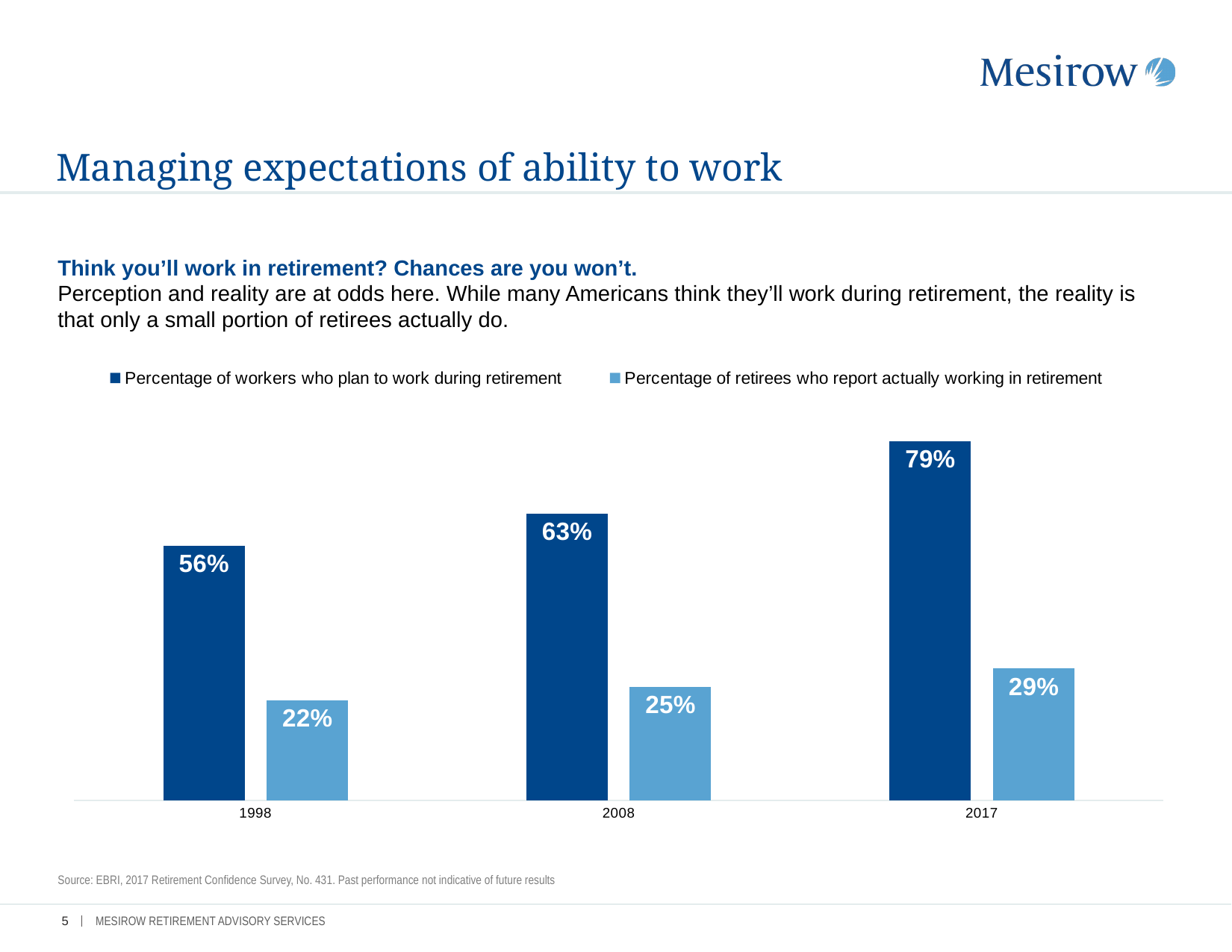
What is the difference between the percentage of workers who plan to work during retirement and the percentage of retirees actually working in retirement in 2017? 50% In which year was the percentage of workers who plan to work during retirement highest? 2017 How many series does the legend list? 2 What percentage of workers planned to work during retirement in 2017? 79% By how much did the percentage of workers who plan to work during retirement increase from 1998 to 2017? 23% How many years are shown on the x axis of the chart? 3 Which is larger in 2008: the percentage of workers who plan to work during retirement or the percentage of retirees who report actually working in retirement? Percentage of workers who plan to work during retirement In which year was the percentage of retirees who report actually working in retirement lowest? 1998 What percentage of workers planned to work during retirement in 2008? 63% Does the percentage of retirees who report actually working in retirement rise or fall from 1998 to 2017? Rise What percentage of retirees reported actually working in retirement in 1998? 22% What kind of chart is shown on the slide? Bar chart